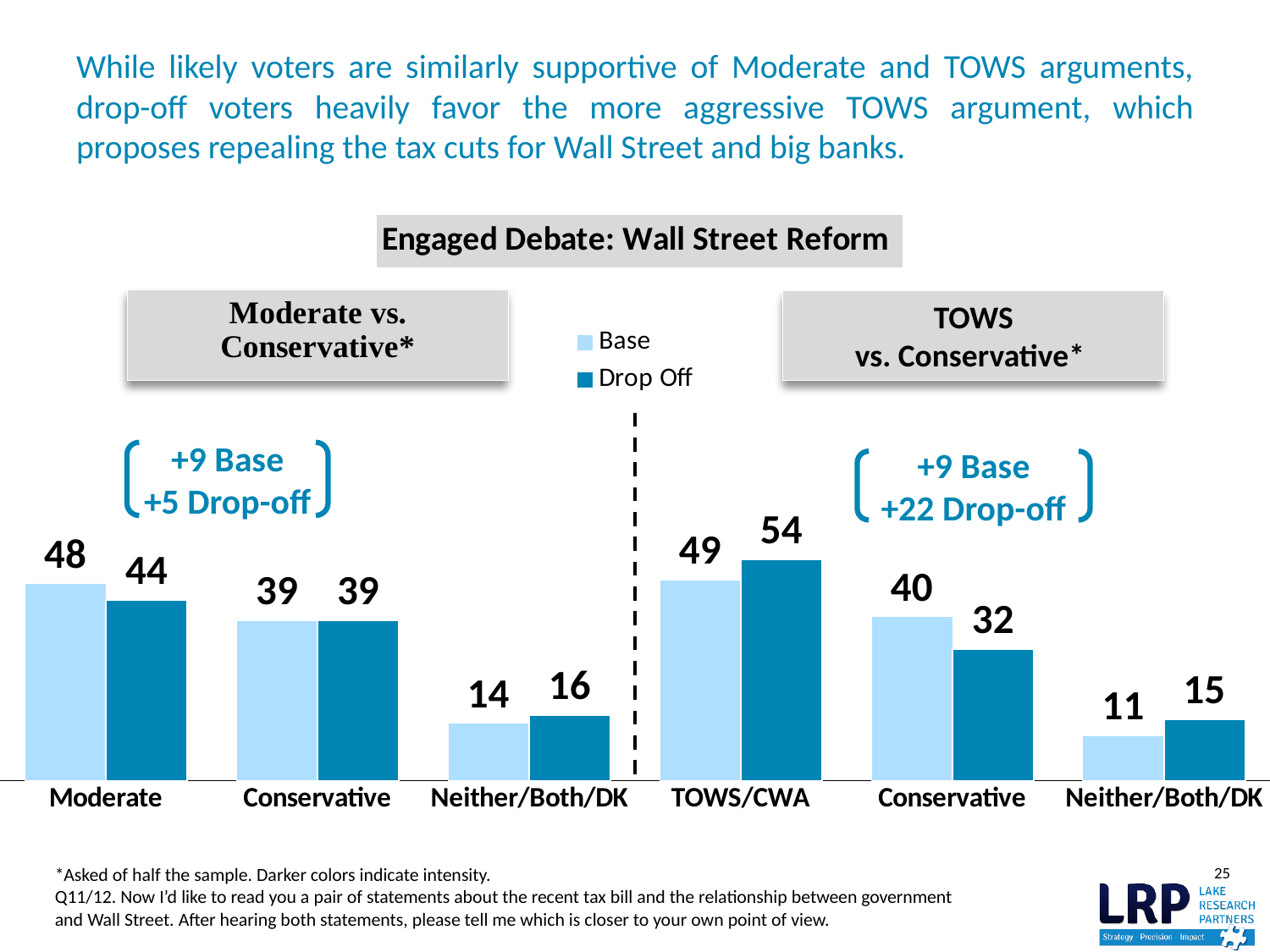
What is the difference between the Drop Off and Base values for TOWS/CWA? 5 What is the Base value for TOWS/CWA? 49 Which is larger, the Base value for Moderate or the Base value for TOWS/CWA? TOWS/CWA Which category has the highest Drop Off value? TOWS/CWA In the TOWS vs. Conservative section, what is the difference between the Base and Drop Off values for Conservative? 8 What is the title of the chart? Engaged Debate: Wall Street Reform In the TOWS vs. Conservative section, what is the Drop Off value for Conservative? 32 What kind of chart is shown? Bar chart How many series does the legend list? 2 Which category has the lowest Base value? Neither/Both/DK (TOWS vs. Conservative section) What is the Drop Off value for Moderate? 44 In the Moderate vs. Conservative section, what is the Base value for Neither/Both/DK? 14